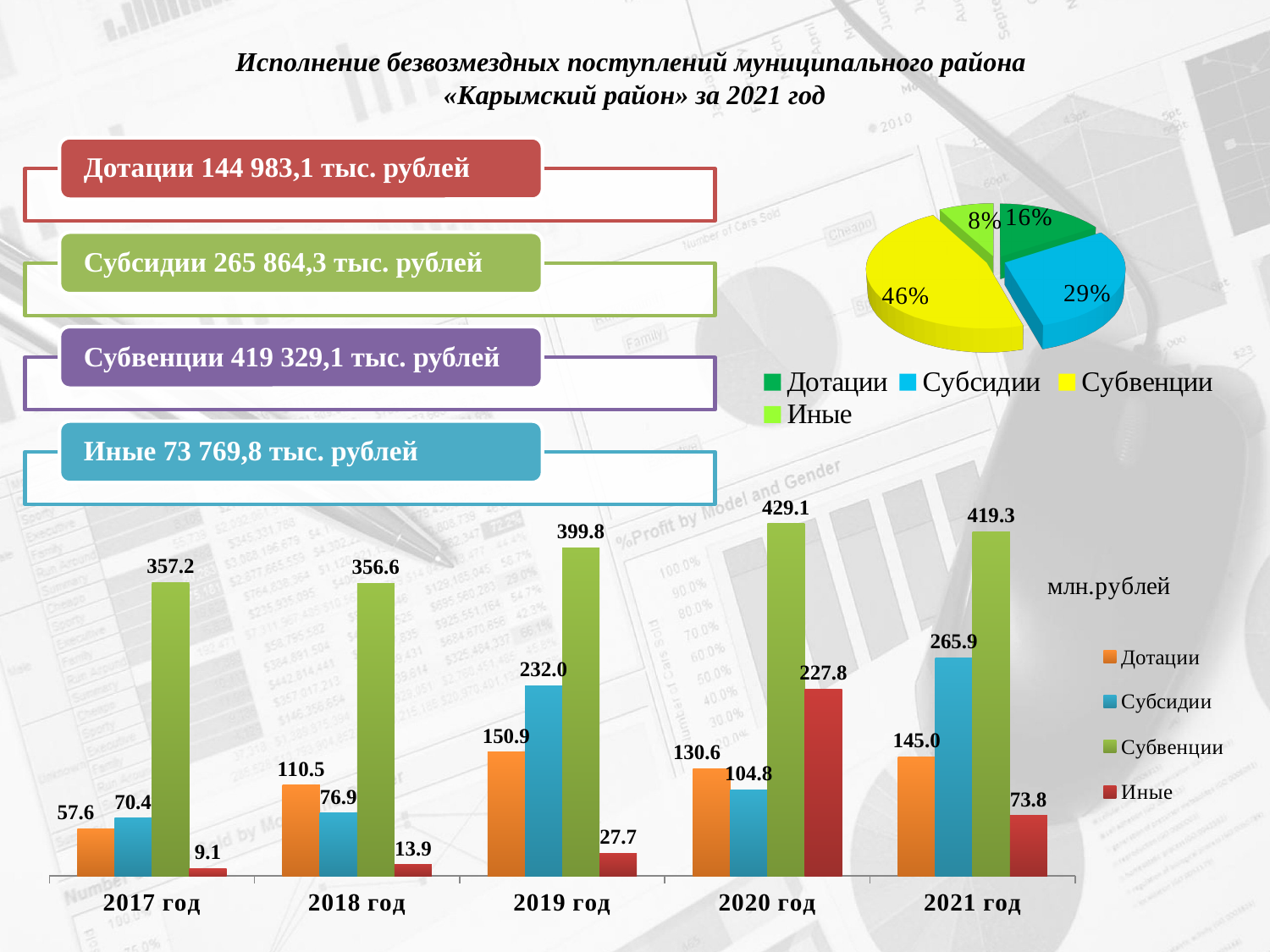
In the bar chart at the bottom, what is the value for Иные in 2017 год? 9.1 In the pie chart, what share does Дотации have? 16% In the bar chart at the bottom, what is the value for Субвенции in 2020 год? 429.1 In the bar chart at the bottom, what is the difference between Дотации in 2019 год and Дотации in 2017 год? 93.3 What type of chart is shown at the bottom of the slide? Bar chart In the bar chart at the bottom, in which year is the Субвенции value highest? 2020 год In the bar chart at the bottom, which is larger: Субсидии in 2019 год or Субсидии in 2020 год? Субсидии in 2019 год In the bar chart at the bottom, what is the value for Субсидии in 2021 год? 265.9 How many year categories are shown on the x axis of the bar chart at the bottom? 5 In the pie chart, what share does Субвенции have? 46% In the pie chart, which category has the smallest slice? Иные How many series does the pie chart legend list? 4